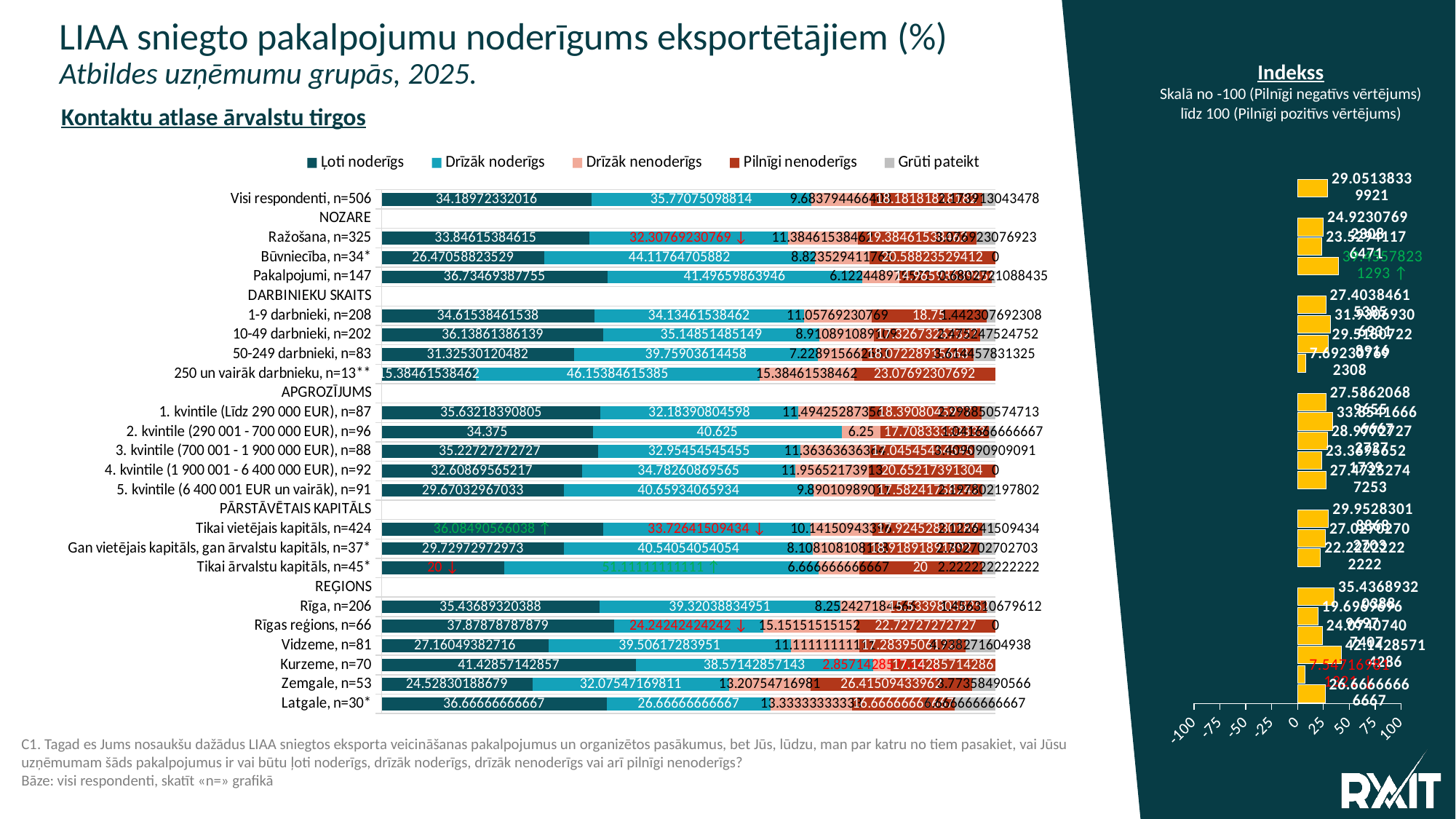
In the main chart, how many categories are listed under the REĢIONS group? 6 In the main chart, what is the 'Ļoti noderīgs' value for 'Visi respondenti, n=506'? 34.18972332016 In the 'Indekss' chart on the right, what is the index value for 'Visi respondenti, n=506'? 29.05138339921 In the main chart, what is the 'Pilnīgi nenoderīgs' value for 'Rīgas reģions, n=66'? 22.72727272727 How many series does the legend of the main chart list? 5 What kind of chart is the main chart on the left of the slide? Stacked bar chart In the 'Indekss' chart on the right, is the index value for 'Rīga, n=206' greater or less than 25? greater In the main chart, which category has the highest 'Ļoti noderīgs' value? Kurzeme, n=70 In the main chart, what is the difference between the 'Drīzāk noderīgs' and 'Ļoti noderīgs' values for '2. kvintile (290 001 - 700 000 EUR), n=96'? 6.25 In the main chart, what is the 'Drīzāk noderīgs' value for 'Tikai ārvalstu kapitāls, n=45*'? 51.11111111111 In the main chart, for 'Būvniecība, n=34*', which is larger: 'Ļoti noderīgs' or 'Drīzāk noderīgs'? Drīzāk noderīgs In the main chart, which category has the lowest 'Ļoti noderīgs' value? 250 un vairāk darbnieku, n=13**